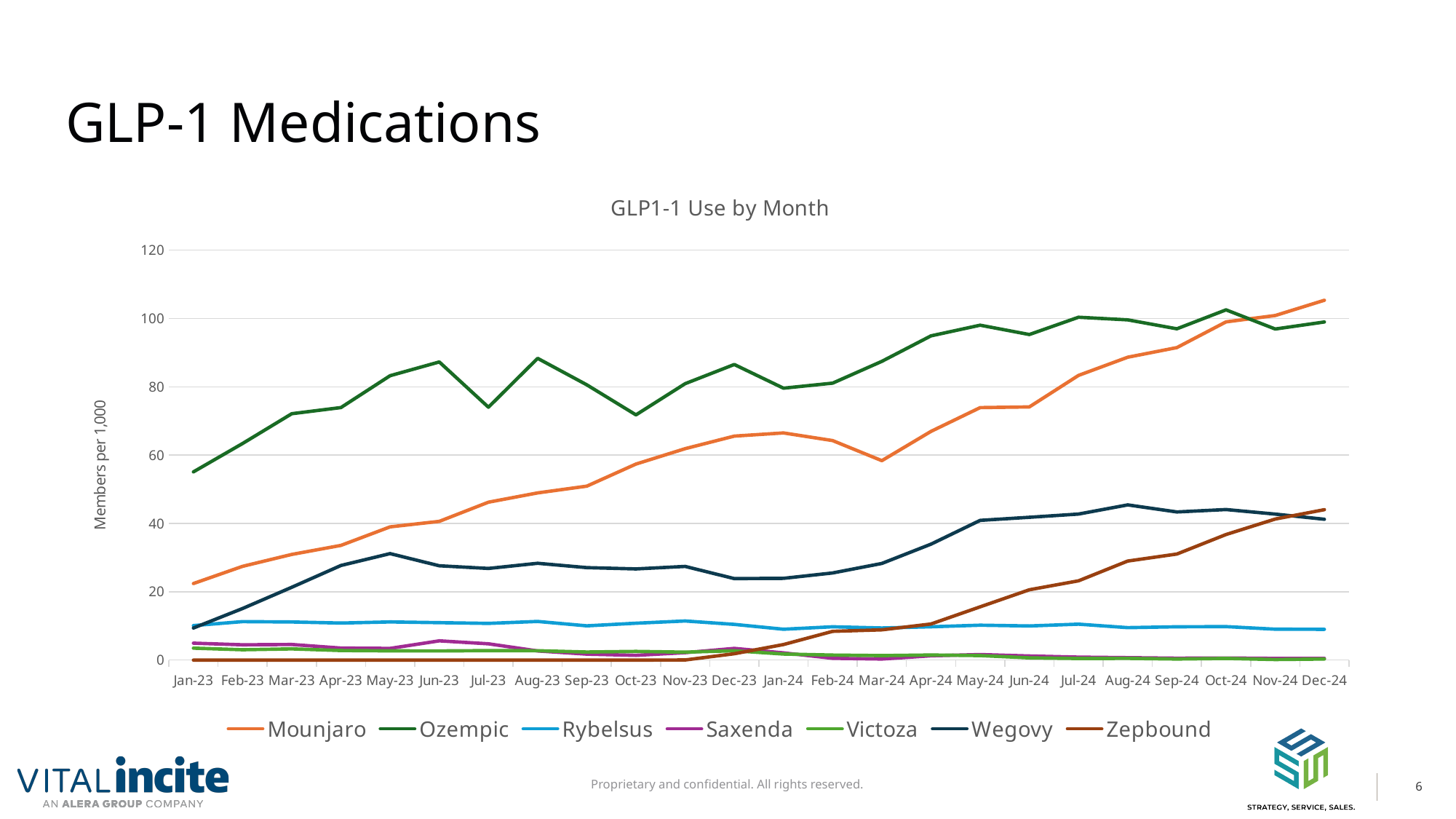
What is the title of the chart? GLP1-1 Use by Month Is the value for Ozempic in Jan-23 greater or less than 40? greater What is the label on the vertical axis? Members per 1,000 Is the value for Mounjaro in Dec-24 greater or less than 100? greater How many months are plotted along the x axis? 24 What kind of chart is shown on the slide? line chart Which medication has the highest value in Dec-24? Mounjaro Which medication has the lowest value in Jan-23? Zepbound Does the value for Mounjaro generally rise or fall from Jan-23 to Dec-24? rise Which is larger in Jan-23, the value for Ozempic or the value for Mounjaro? Ozempic Which medication has the highest value in Jan-23? Ozempic How many series does the legend list? 7